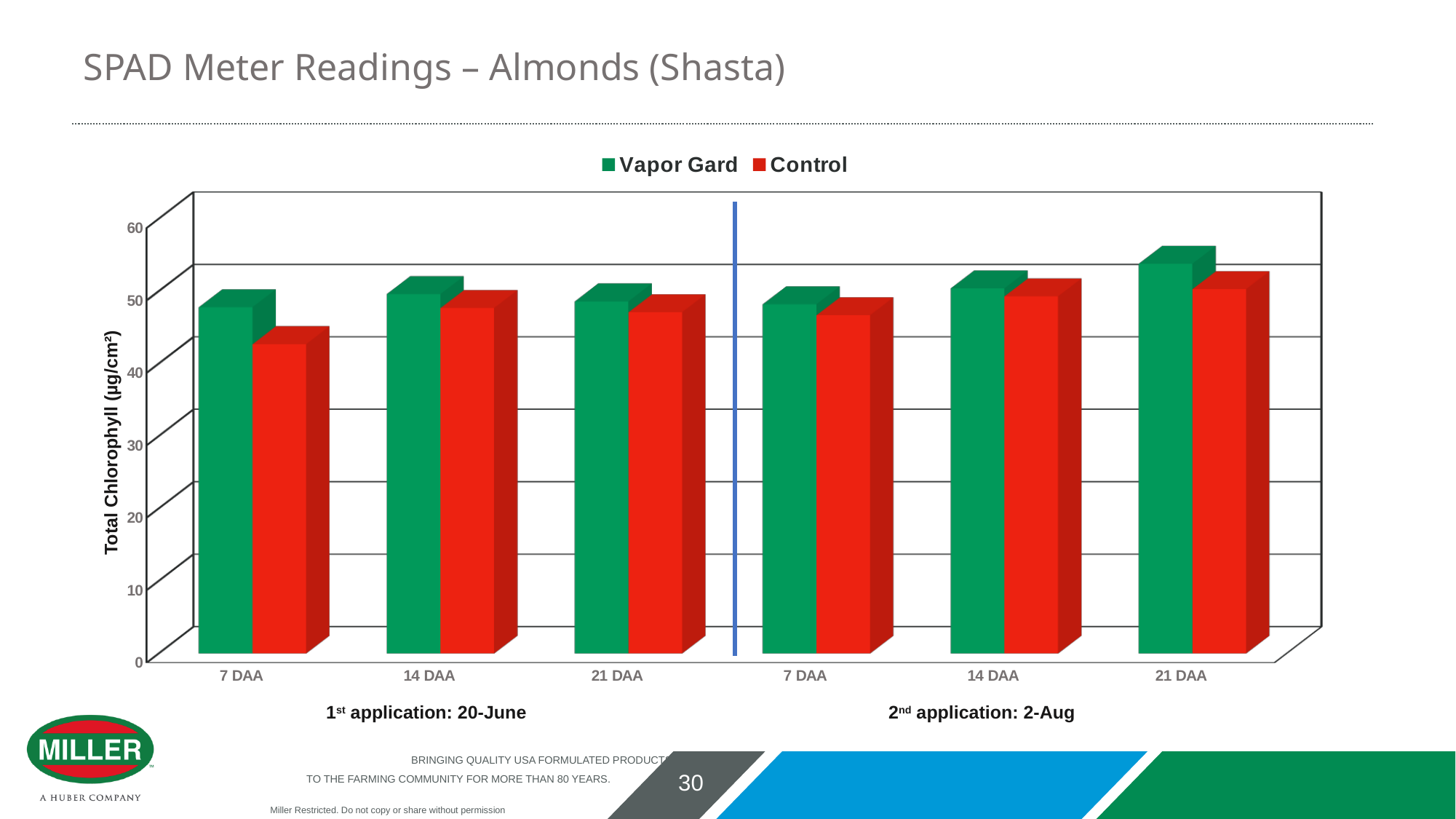
Is the Vapor Gard value at 21 DAA after the 2nd application (2-Aug) greater or less than 50? greater Is the Control value at 7 DAA after the 1st application (20-June) greater or less than 40? greater Is the Control value at 7 DAA after the 1st application (20-June) greater or less than 50? less Across all readings, at which point is the Vapor Gard value highest? 21 DAA, 2nd application (2-Aug) At 7 DAA after the 1st application (20-June), which is larger, Vapor Gard or Control? Vapor Gard How many category groups (DAA readings) are plotted along the x axis? 6 What kind of chart is shown on the slide? Bar chart What is the y-axis title of the chart? Total Chlorophyll (µg/cm²) Do the Vapor Gard values rise or fall from 7 DAA to 21 DAA after the 2nd application (2-Aug)? rise Across all readings, at which point is the Control value lowest? 7 DAA, 1st application (20-June) Which series is shown in green in the legend? Vapor Gard How many series does the legend list? 2